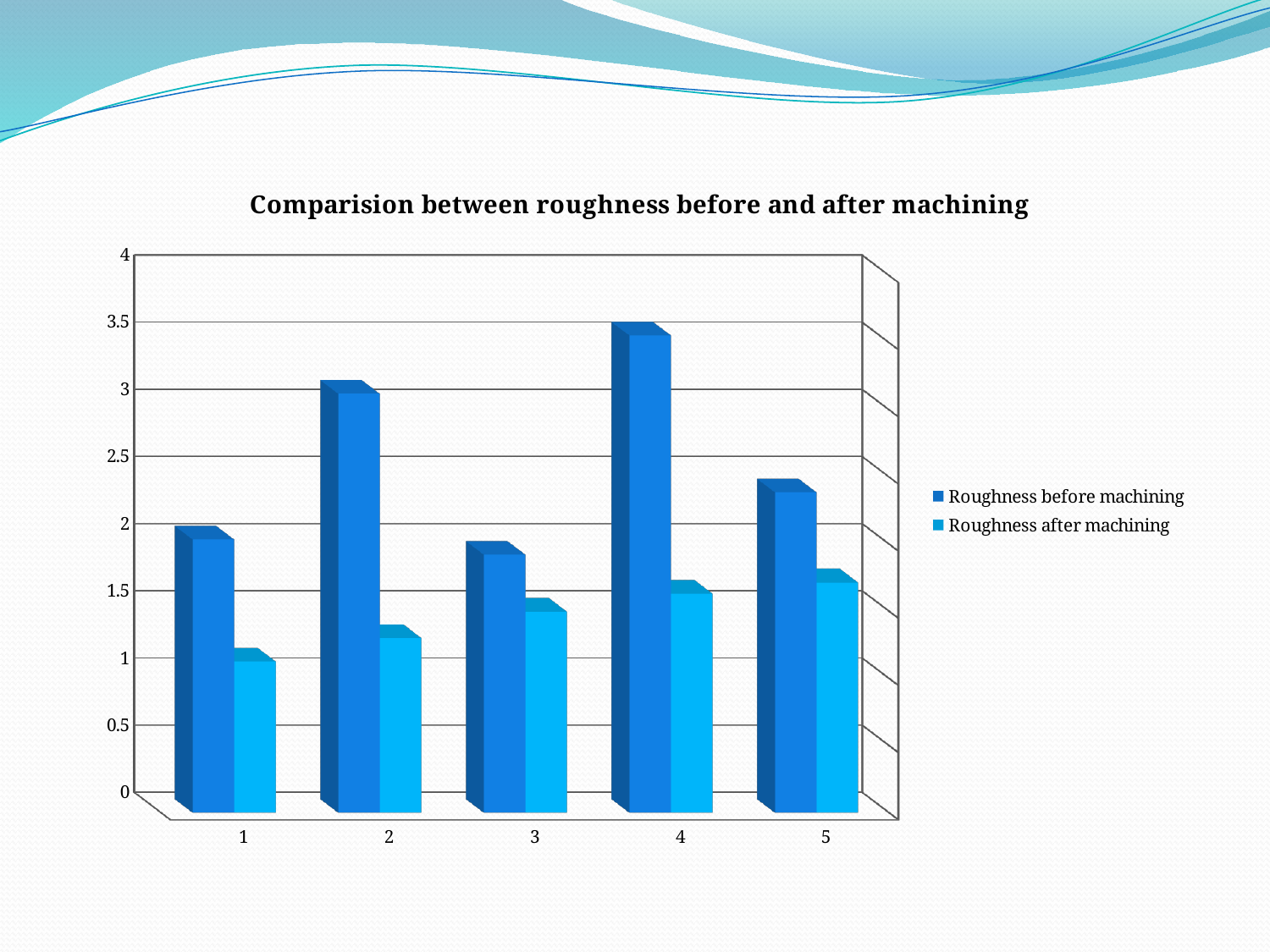
Is the value for Roughness before machining at category 4 greater or less than 3? greater Is the value for Roughness before machining at category 2 greater or less than 2.5? greater What kind of chart is shown on the slide? bar chart Which category has the highest value for Roughness before machining? 4 Is the value for Roughness after machining at category 3 greater or less than 1? greater How many categories are shown on the x axis? 5 How many series does the legend list? 2 What is the title of the chart? Comparision between roughness before and after machining Do the values for Roughness after machining rise or fall from category 1 to category 5? rise Which category has the lowest value for Roughness after machining? 1 Which is larger at category 3: Roughness before machining or Roughness after machining? Roughness before machining